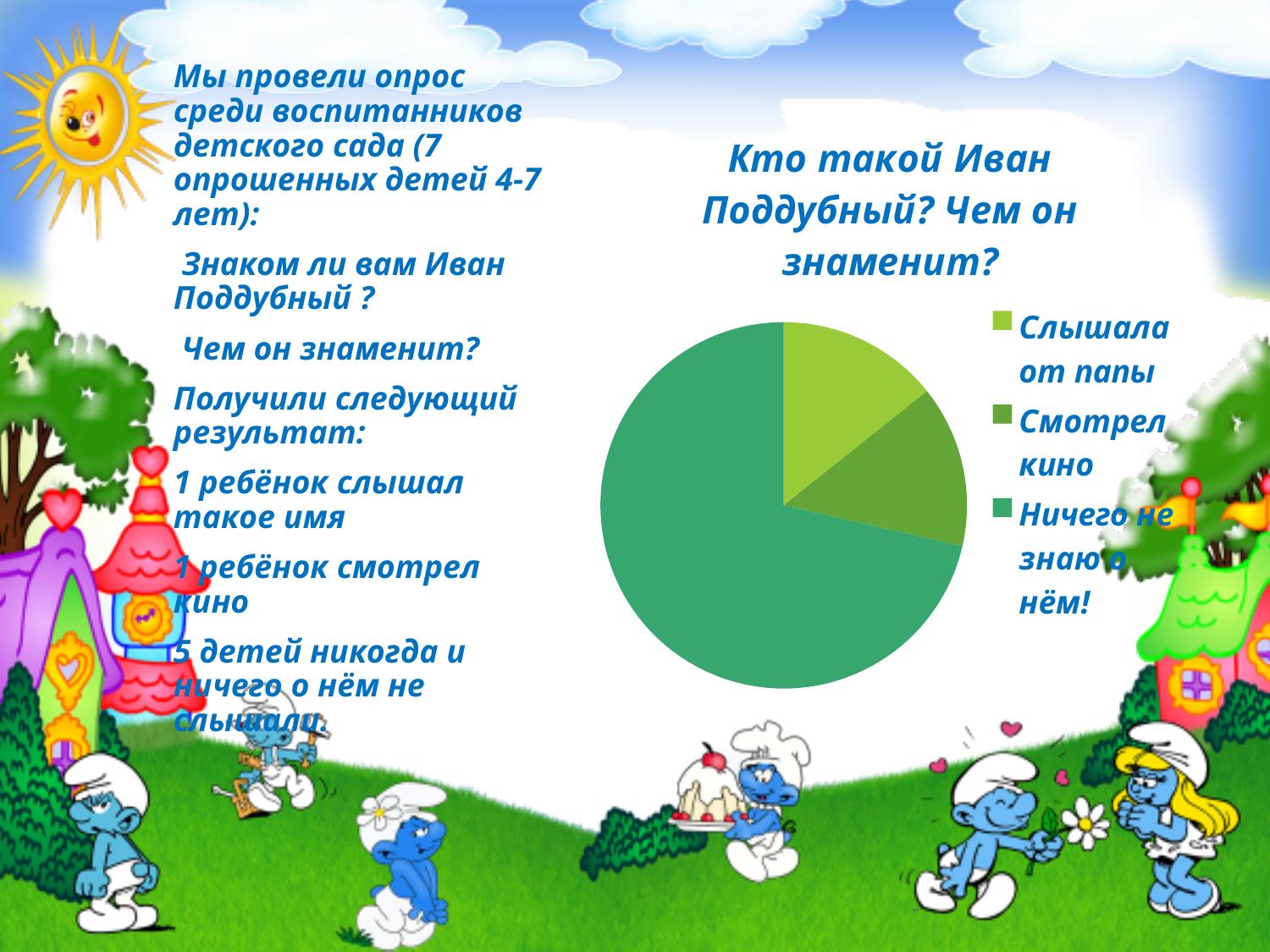
Which legend entry is shown in the lightest green colour? Слышала от папы Which slice is larger: "Ничего не знаю о нём!" or "Смотрел кино"? Ничего не знаю о нём! Which slice is larger: "Ничего не знаю о нём!" or "Слышала от папы"? Ничего не знаю о нём! Does the slice for "Ничего не знаю о нём!" take up more or less than half of the pie? more How many slices does the pie chart have? 3 What kind of chart is shown on the slide? pie chart Which category has the largest slice of the pie chart? Ничего не знаю о нём! What is the title of the pie chart? Кто такой Иван Поддубный? Чем он знаменит? How many entries does the legend of the pie chart list? 3